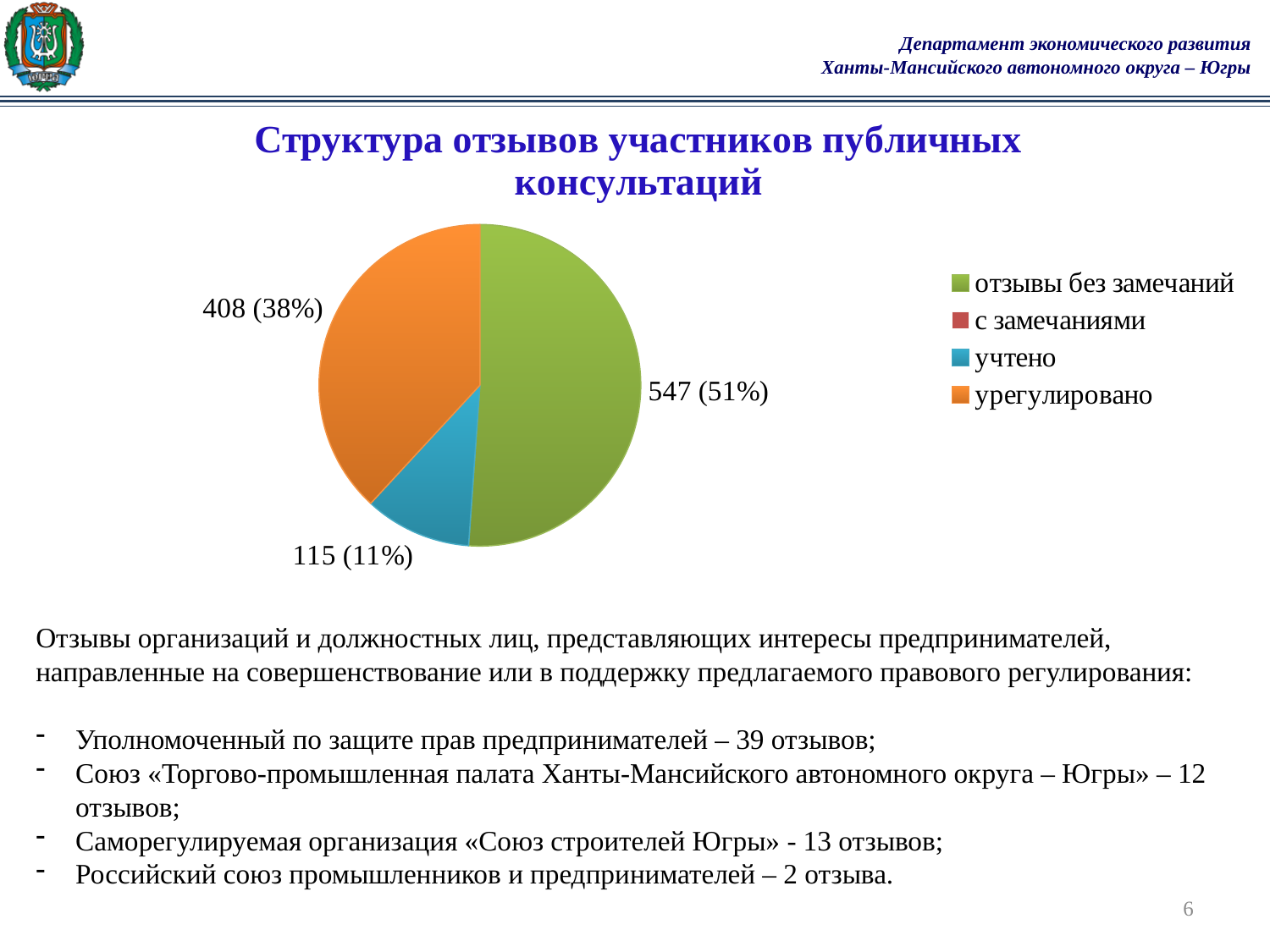
Which labelled slice is the smallest? учтено What value is shown for the slice 'отзывы без замечаний'? 547 (51%) Which category has the largest slice of the pie? отзывы без замечаний What colour is the slice for 'учтено'? blue What value is shown for the slice 'урегулировано'? 408 (38%) What value is shown for the slice 'учтено'? 115 (11%) What type of chart is shown on the slide? pie chart Which is larger: the value for 'урегулировано' or the value for 'учтено'? урегулировано What is the difference between the values for 'отзывы без замечаний' and 'урегулировано'? 139 What is the title of the chart? Структура отзывов участников публичных консультаций How many entries does the chart legend list? 4 What share of the pie does 'урегулировано' represent? 38%